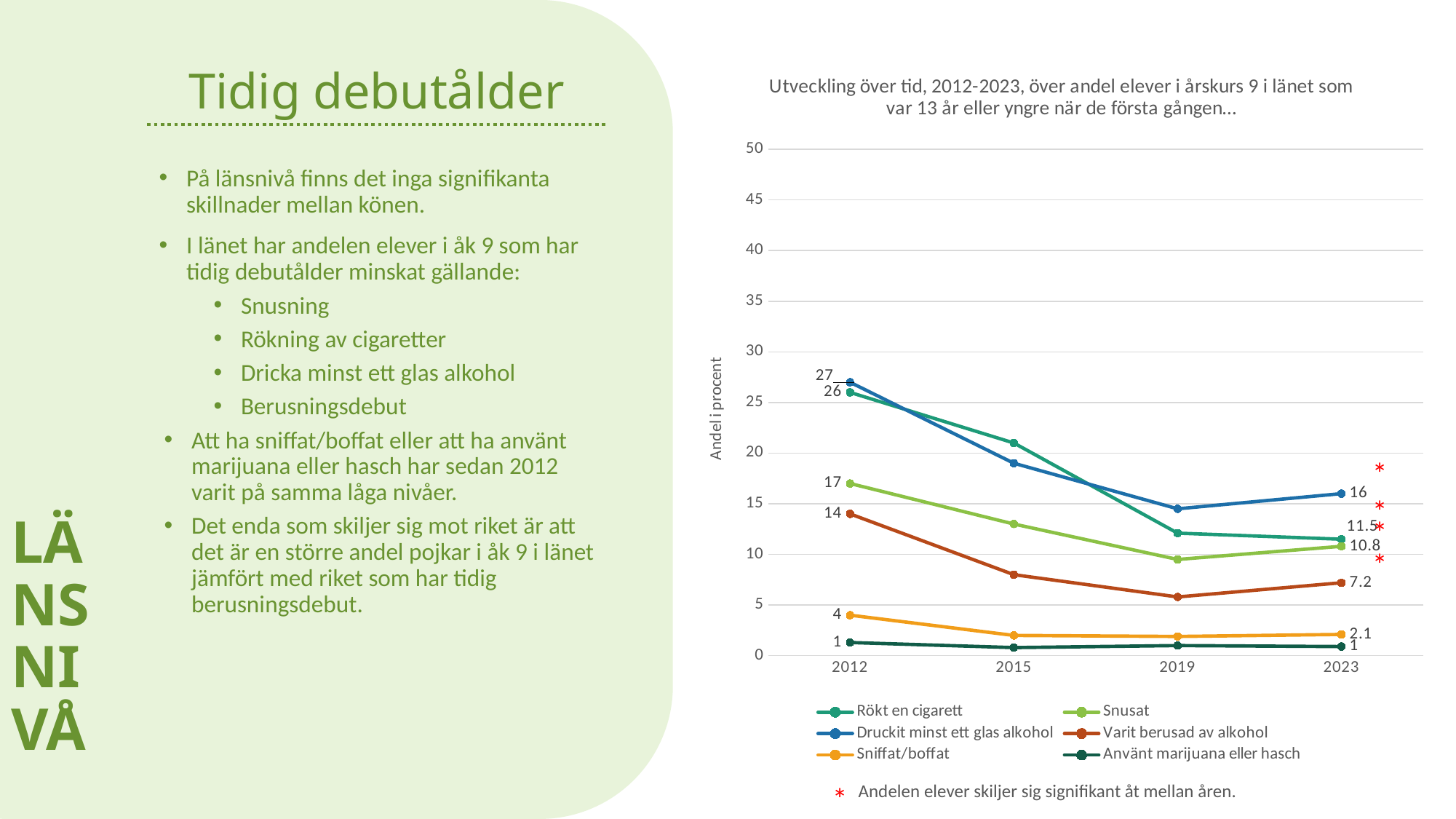
What is the value for 'Snusat' in 2012? 17 How many series does the legend list? 6 Which series has the lowest value in 2023? Använt marijuana eller hasch What is the value for 'Varit berusad av alkohol' in 2023? 7.2 Is the value for 'Varit berusad av alkohol' in 2015 greater or less than 5? greater How many years are shown on the x axis? 4 What is the label of the y axis? Andel i procent By how much did the value for 'Druckit minst ett glas alkohol' fall from 2012 to 2023? 11 Does the value for 'Snusat' rise or fall from 2012 to 2023? fall What is the value for 'Druckit minst ett glas alkohol' in 2012? 27 What kind of chart is shown on the slide? line chart What is the value for 'Sniffat/boffat' in 2023? 2.1